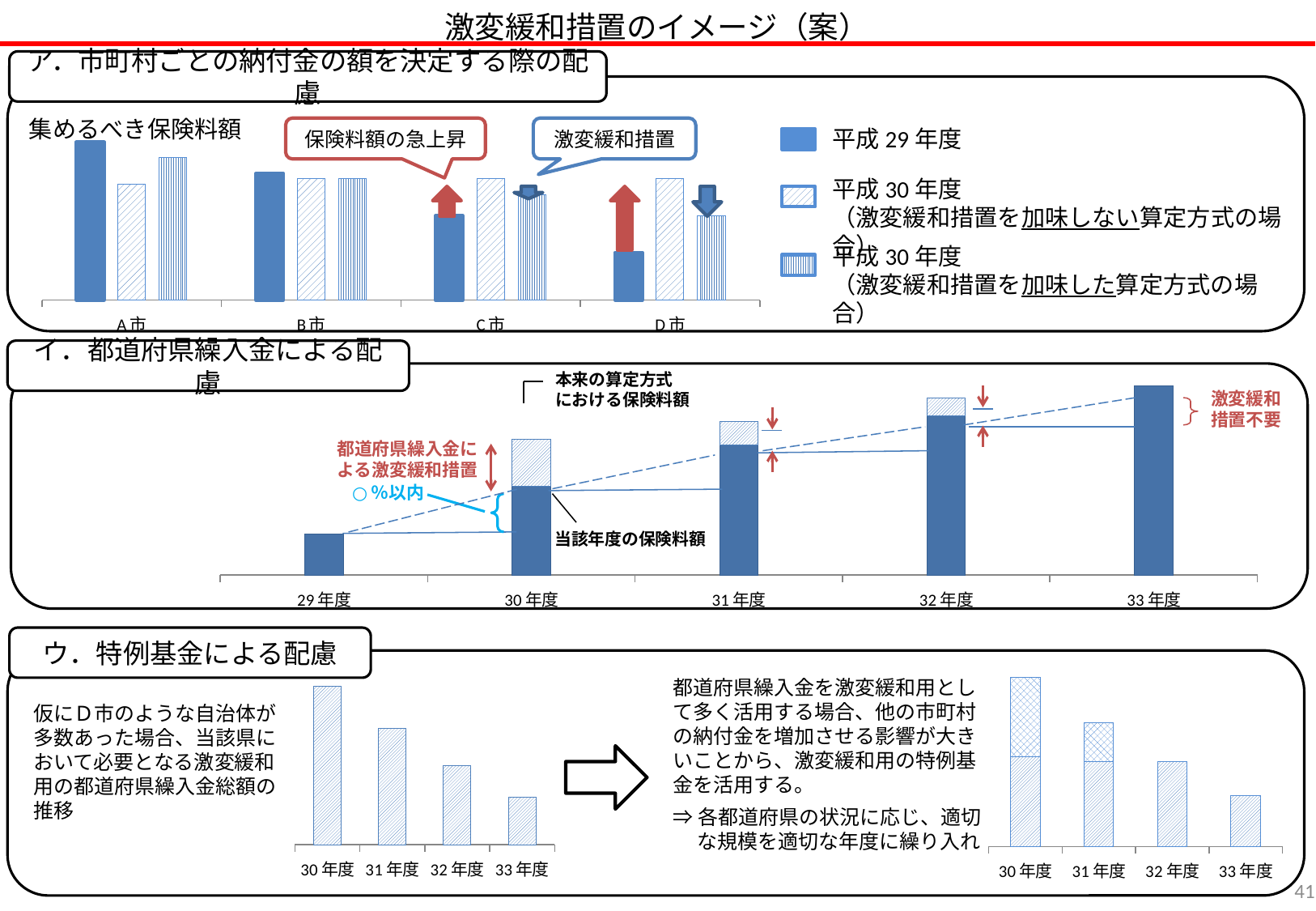
In the top chart (ア), which municipality has the tallest 平成29年度 bar? A市 In the bottom-left chart (ウ), which fiscal year has the tallest bar? 30年度 In the top chart (ア), how many series does the legend list? 3 In the top chart (ア), which municipality has the shortest 平成29年度 bar? D市 In the middle chart (イ), do the solid bars rise or fall from 29年度 to 33年度? rise In the bottom-right chart (ウ), which fiscal year has the shortest bar? 33年度 In the middle chart (イ), how many fiscal years are shown on the x axis? 5 What kind of chart is the top chart (ア)? bar chart In the top chart (ア), how many municipalities are shown on the x axis? 4 In the top chart (ア), for D市, which is larger: the 平成29年度 bar or the 平成30年度 (加味しない) bar? 平成30年度 (加味しない) In the bottom-right chart (ウ), how many fiscal years are shown on the x axis? 4 In the bottom-left chart (ウ), do the bars rise or fall from 30年度 to 33年度? fall